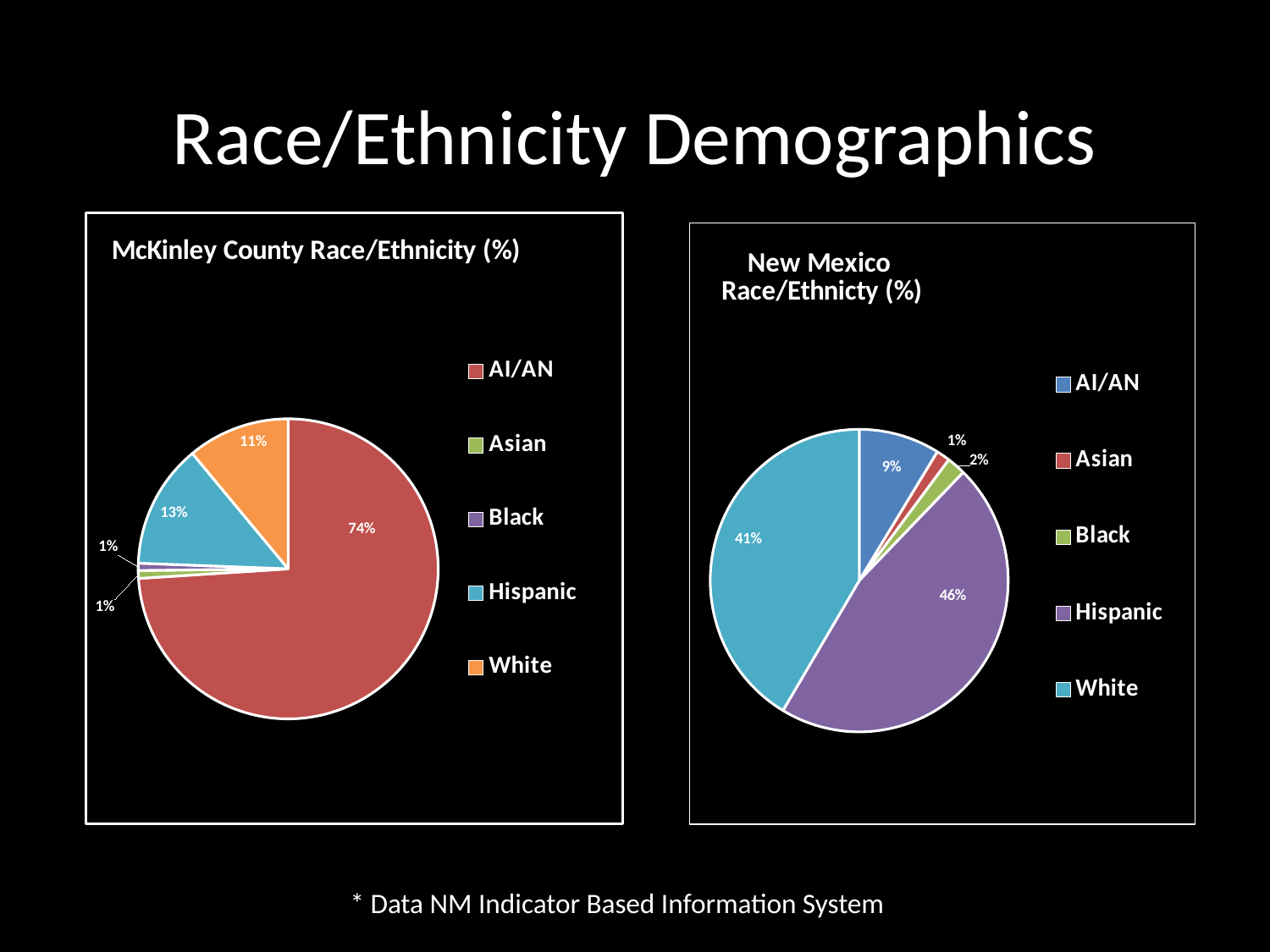
In the McKinley County Race/Ethnicity (%) chart, which is larger, the Hispanic slice or the White slice? Hispanic In the McKinley County Race/Ethnicity (%) chart, what share is White? 11% In the New Mexico Race/Ethnicty (%) chart, what share is Hispanic? 46% In the McKinley County Race/Ethnicity (%) chart, which group has the largest slice? AI/AN In the New Mexico Race/Ethnicty (%) chart, what is the difference between the Hispanic and White shares? 5% In the New Mexico Race/Ethnicty (%) chart, what share is AI/AN? 9% In the McKinley County Race/Ethnicity (%) chart, what share is Hispanic? 13% How many groups does the legend of the New Mexico Race/Ethnicty (%) chart list? 5 What type of chart is the McKinley County Race/Ethnicity (%) chart? Pie chart In the McKinley County Race/Ethnicity (%) chart, what share is AI/AN? 74% In the New Mexico Race/Ethnicty (%) chart, which group has the smallest slice? Asian In the New Mexico Race/Ethnicty (%) chart, what share is White? 41%